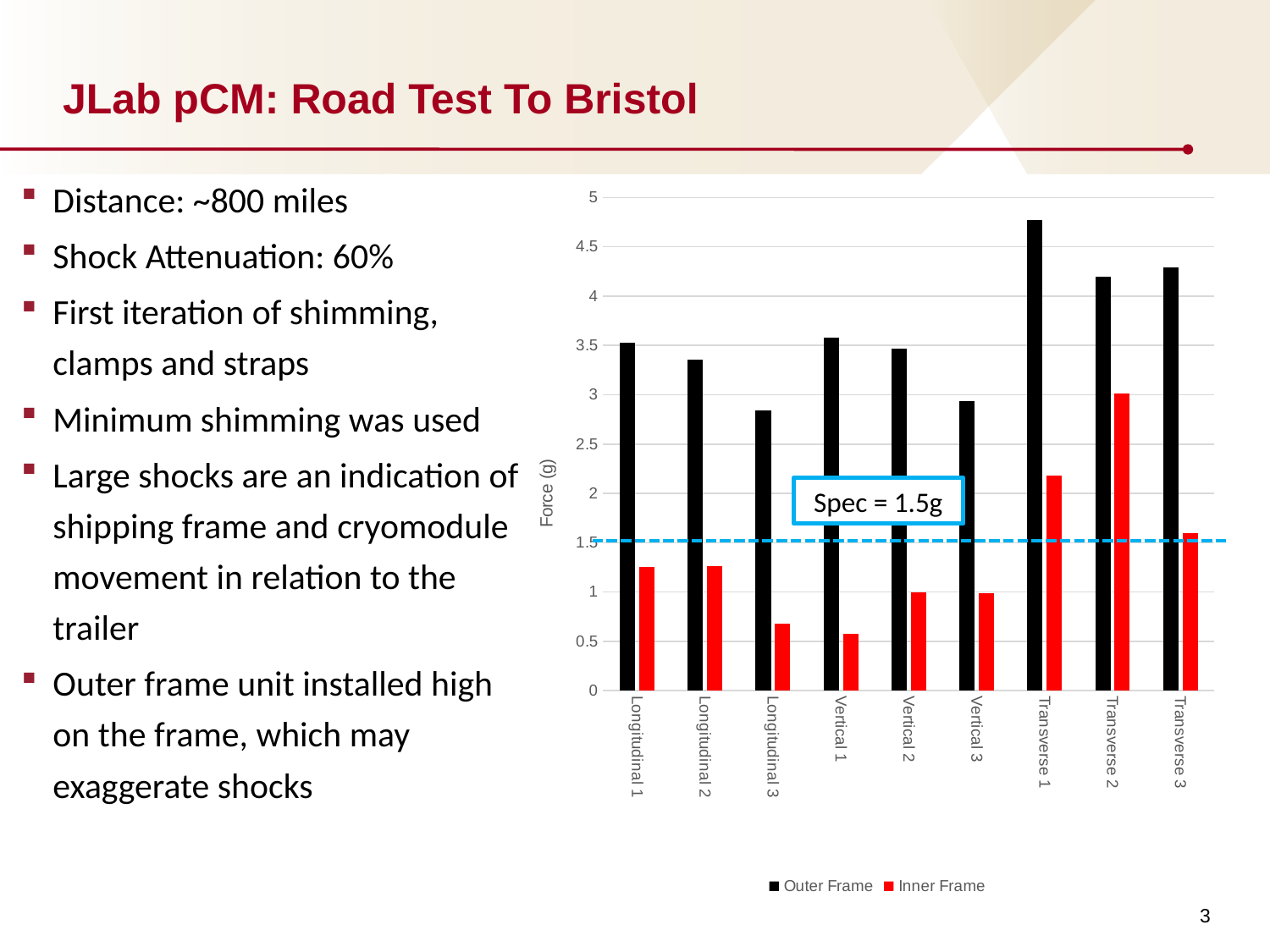
Which is larger, the Inner Frame value for Transverse 2 or for Transverse 1? Transverse 2 What kind of chart is shown on the slide? bar chart Is the Inner Frame value for Longitudinal 3 greater or less than 1? less How many categories are shown along the x axis of the chart? 9 Which category has the highest Outer Frame value? Transverse 1 Which category has the highest Inner Frame value? Transverse 2 Is the Inner Frame value for Transverse 2 greater or less than 2.5? greater Which is larger for Longitudinal 1, the Outer Frame value or the Inner Frame value? Outer Frame How many series does the chart legend list? 2 Is the Outer Frame value for Transverse 1 greater or less than 4.5? greater What spec value is marked by the dashed line on the chart? 1.5g